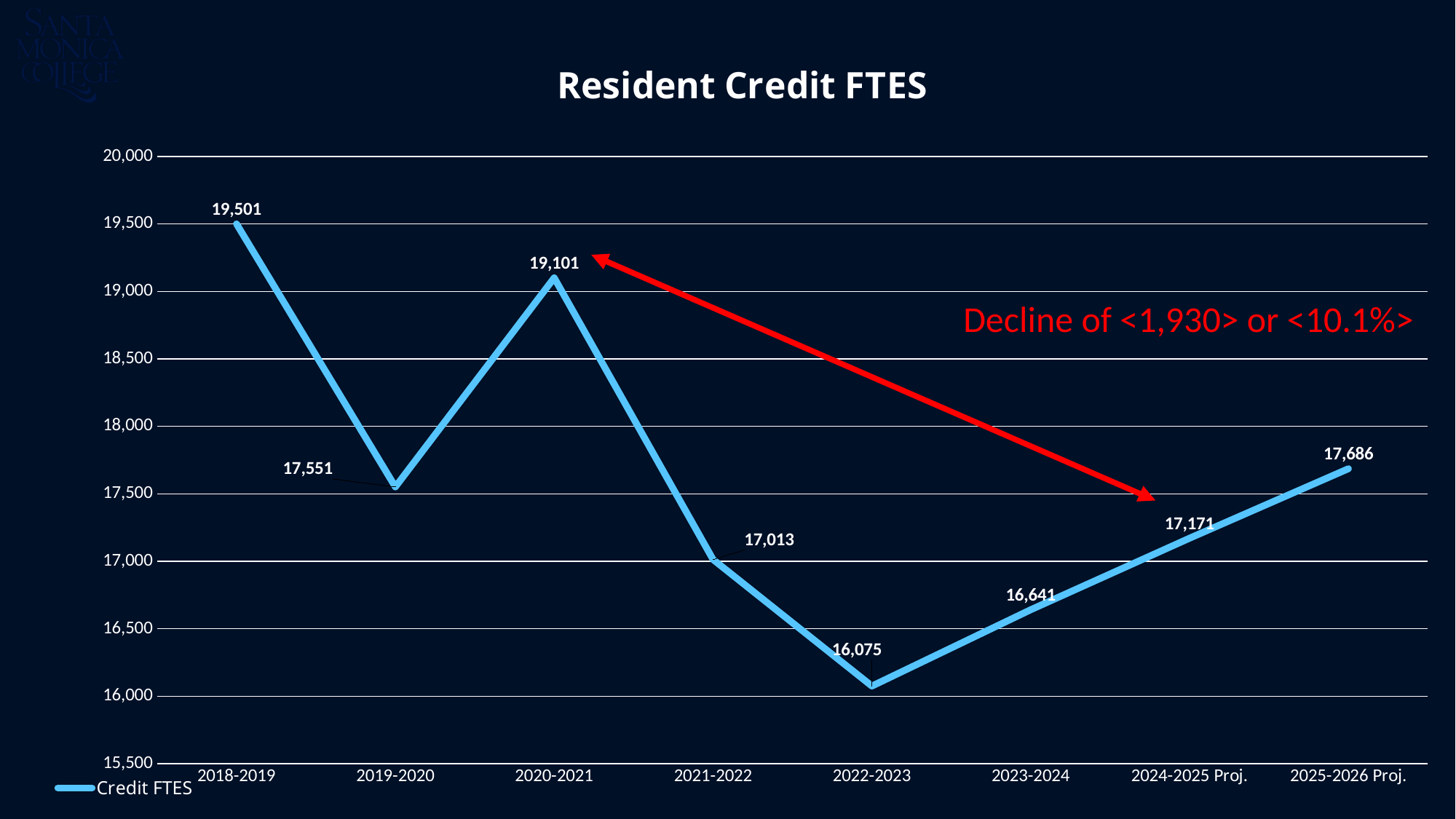
Which is larger, the Credit FTES value for 2019-2020 or for 2023-2024? 2019-2020 What is the difference between the Credit FTES values for 2020-2021 and 2024-2025 Proj.? 1,930 How many series does the legend list? 1 What is the projected Credit FTES value for 2025-2026 Proj.? 17,686 How many academic years are plotted on the x axis? 8 What is the title of the chart? Resident Credit FTES Which year has the lowest Credit FTES value? 2022-2023 Which year has the highest Credit FTES value? 2018-2019 What is the Credit FTES value for 2018-2019? 19,501 What is the Credit FTES value for 2022-2023? 16,075 What kind of chart is shown on the slide? line chart Is the Credit FTES value for 2021-2022 greater or less than 17,500? less